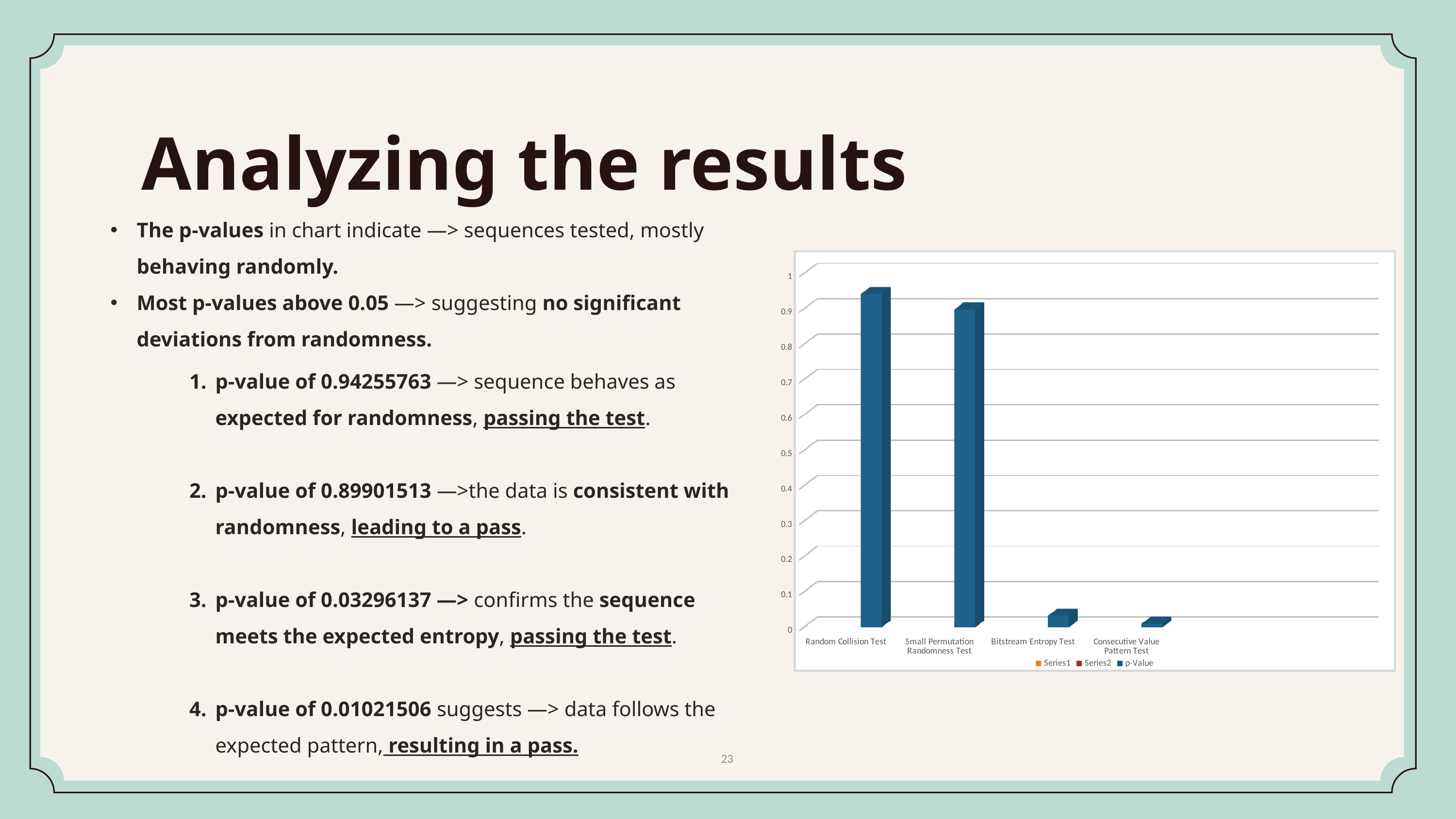
Is the value for Random Collision Test greater or less than 0.9? greater Is the value for Small Permutation Randomness Test greater or less than 0.8? greater How many categories are shown on the x axis of the chart? 4 What kind of chart is shown on the slide? bar chart Is the value for Consecutive Value Pattern Test greater or less than 0.1? less Which is larger, the bar for Random Collision Test or the bar for Bitstream Entropy Test? Random Collision Test Which category has the highest bar in the chart? Random Collision Test Which category has the lowest bar in the chart? Consecutive Value Pattern Test Do the bar values rise or fall from left to right across the x axis? fall How many series does the chart legend list? 3 What is the name of the series plotted in blue in the chart legend? p-Value